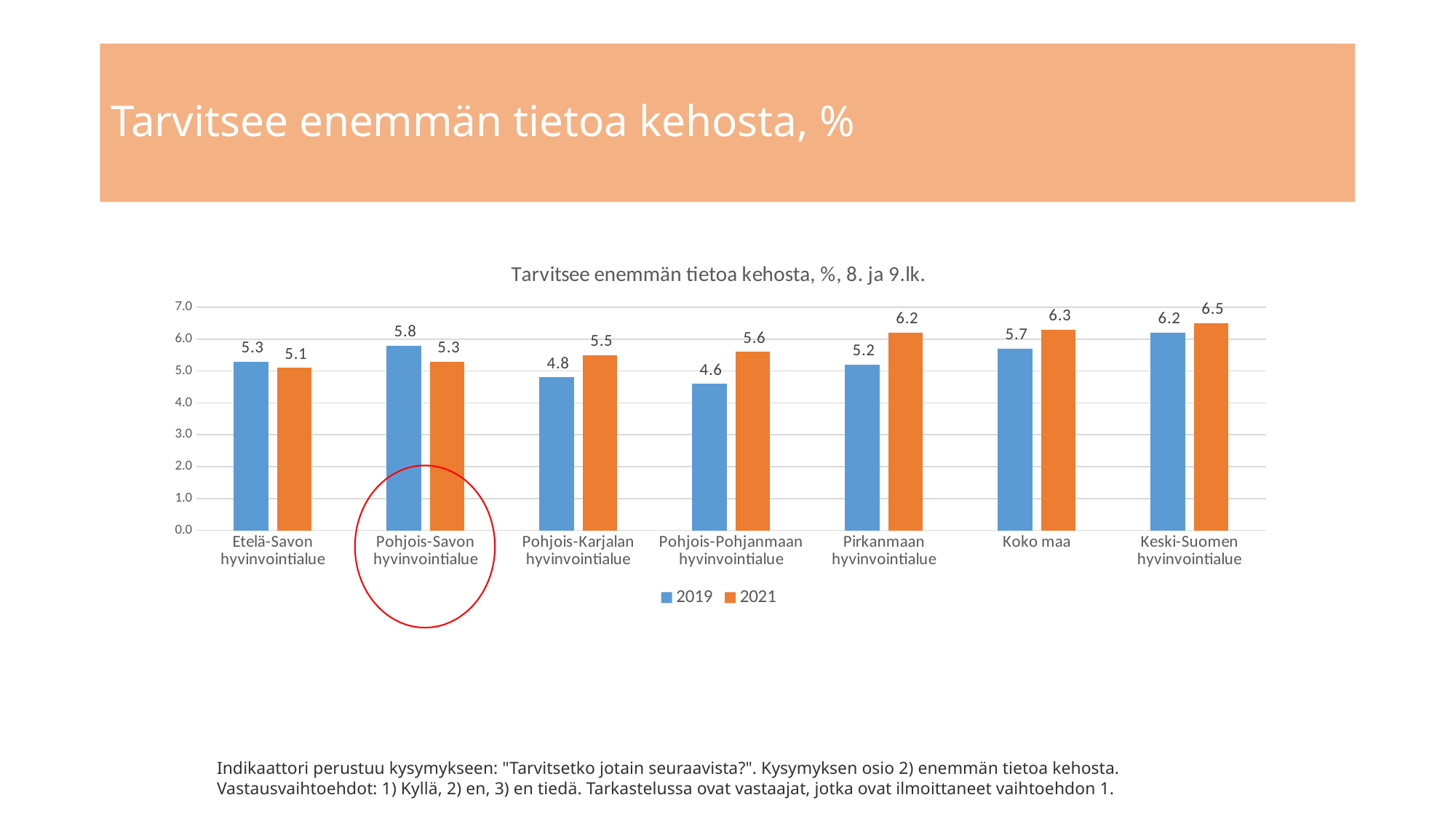
Which is larger for Pohjois-Savon hyvinvointialue, the 2019 value or the 2021 value? 2019 How many series does the legend list? 2 What is the difference between the 2021 and 2019 values for Pirkanmaan hyvinvointialue? 1.0 What is the title of the chart? Tarvitsee enemmän tietoa kehosta, %, 8. ja 9.lk. What is the 2019 value for Pohjois-Savon hyvinvointialue? 5.8 What is the 2021 value for Koko maa? 6.3 Which category has the highest 2021 value? Keski-Suomen hyvinvointialue What kind of chart is shown on the slide? Bar chart Which category is circled in red on the chart? Pohjois-Savon hyvinvointialue What is the 2021 value for Keski-Suomen hyvinvointialue? 6.5 How many categories are shown on the x axis? 7 Which category has the lowest 2019 value? Pohjois-Pohjanmaan hyvinvointialue